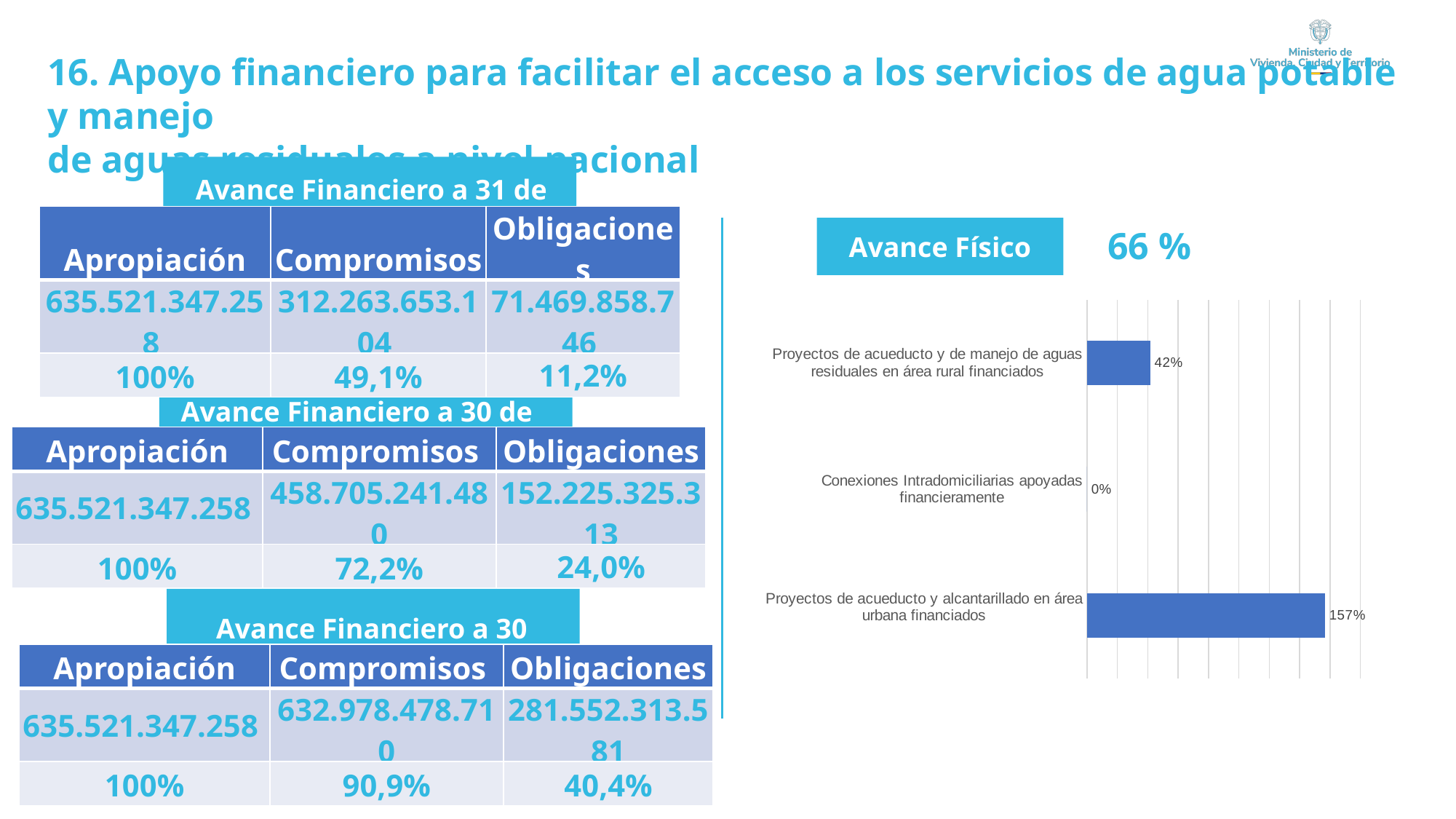
Which category has the lowest value in the bar chart? Conexiones Intradomiciliarias apoyadas financieramente What is the difference between the value for "Proyectos de acueducto y alcantarillado en área urbana financiados" and the value for "Proyectos de acueducto y de manejo de aguas residuales en área rural financiados"? 115% How many categories does the bar chart show? 3 What heading appears above the bar chart on the right side of the slide? Avance Físico Which is larger: the value for "Proyectos de acueducto y de manejo de aguas residuales en área rural financiados" or the value for "Proyectos de acueducto y alcantarillado en área urbana financiados"? Proyectos de acueducto y alcantarillado en área urbana financiados What is the value for "Proyectos de acueducto y alcantarillado en área urbana financiados"? 157% Which category has the highest value in the bar chart? Proyectos de acueducto y alcantarillado en área urbana financiados What kind of chart is shown on the right side of the slide? bar chart What is the value for "Proyectos de acueducto y de manejo de aguas residuales en área rural financiados"? 42% What percentage is shown next to the "Avance Físico" heading above the bar chart? 66 % What is the value for "Conexiones Intradomiciliarias apoyadas financieramente"? 0% What is the difference between the value for "Proyectos de acueducto y de manejo de aguas residuales en área rural financiados" and the value for "Conexiones Intradomiciliarias apoyadas financieramente"? 42%